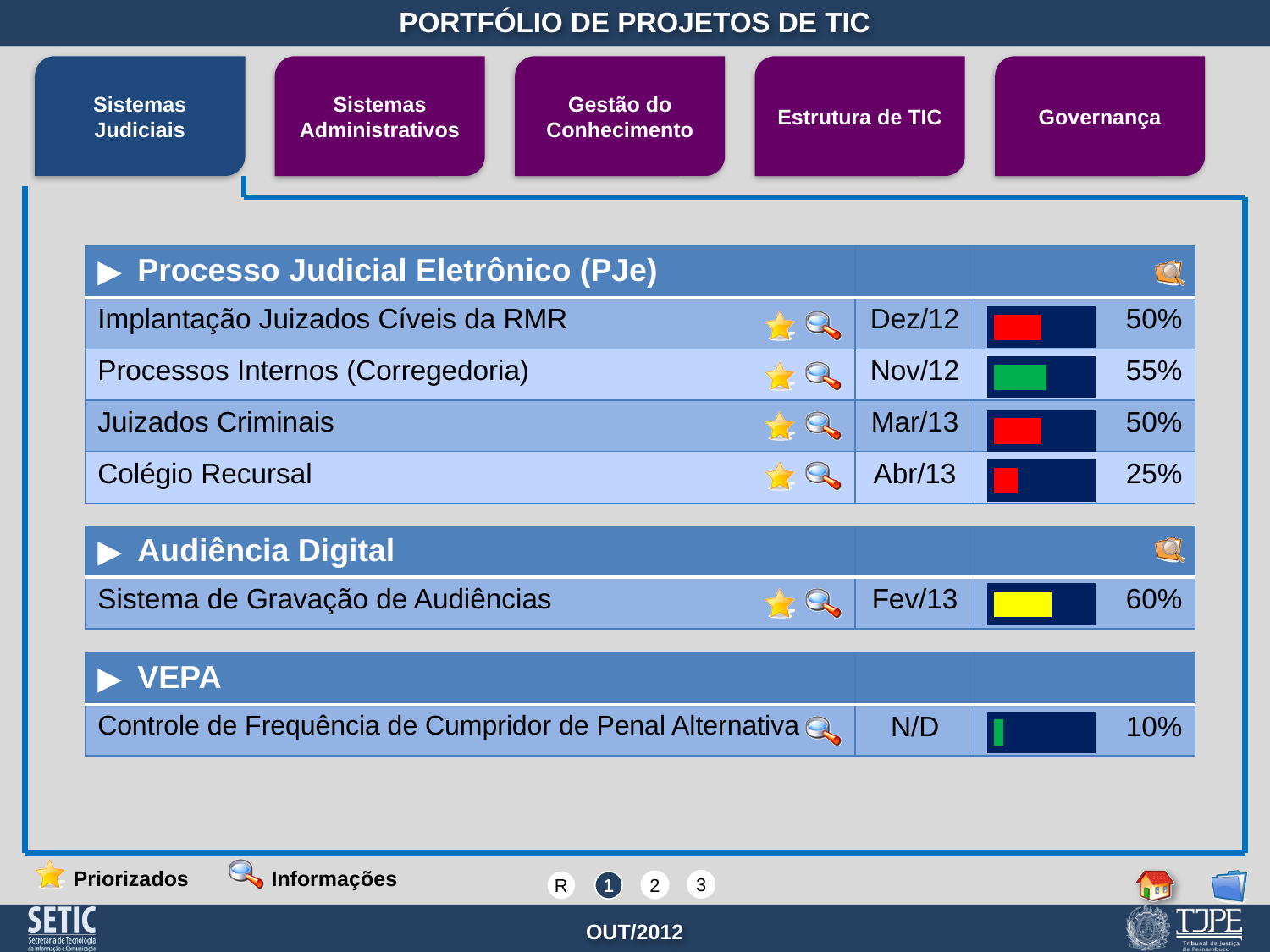
What completion percentage is shown for Controle de Frequência de Cumpridor de Penal Alternativa? 10% Which project has the highest completion percentage on the slide? Sistema de Gravação de Audiências What completion percentage is shown for Implantação Juizados Cíveis da RMR? 50% What is the date shown for Juizados Criminais? Mar/13 What colour is the progress bar for Sistema de Gravação de Audiências? Yellow What completion percentage is shown for Processos Internos (Corregedoria)? 55% Which has a higher completion percentage, Juizados Criminais or Colégio Recursal? Juizados Criminais What is the difference between the completion percentages of Processos Internos (Corregedoria) and Colégio Recursal? 30% How many projects are listed under Processo Judicial Eletrônico (PJe)? 4 What completion percentage is shown for Colégio Recursal? 25% Which project has the lowest completion percentage on the slide? Controle de Frequência de Cumpridor de Penal Alternativa What completion percentage is shown for Sistema de Gravação de Audiências? 60%